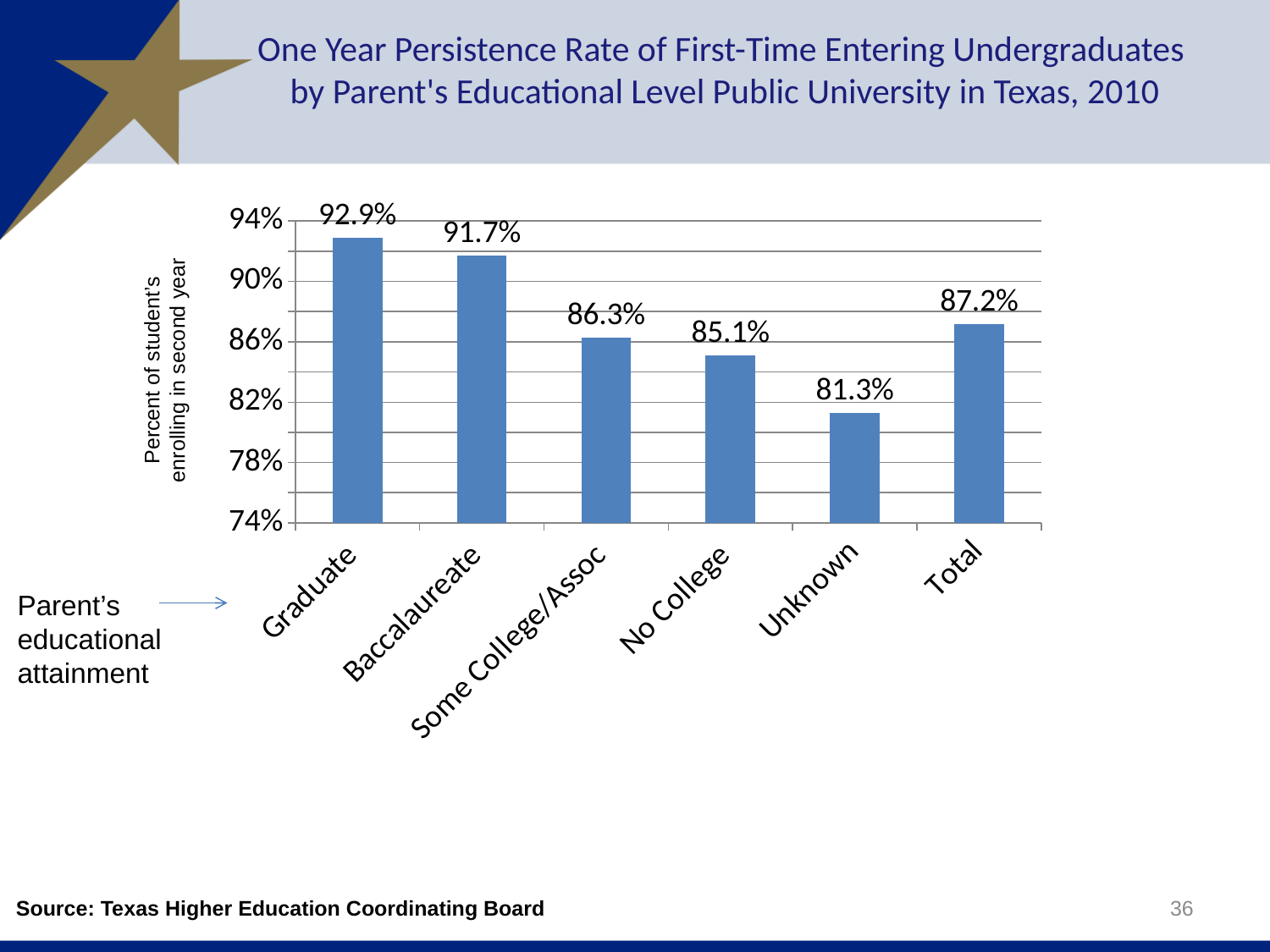
What is the label of the vertical axis? Percent of student's enrolling in second year What is the persistence rate for the Unknown parent education category? 81.3% Which parent educational attainment category has the highest persistence rate? Graduate What is the persistence rate shown for the Total bar? 87.2% Which has a higher persistence rate, Some College/Assoc or No College? Some College/Assoc What type of chart is shown on the slide? Bar chart What is the difference in persistence rate between the Graduate and No College categories? 7.8% Is the persistence rate for Unknown greater or less than 82%? less What is the difference between the Baccalaureate and Some College/Assoc persistence rates? 5.4% Which category has the lowest persistence rate? Unknown How many bars are shown in the chart? 6 What is the one year persistence rate for students whose parents have a Graduate education? 92.9%